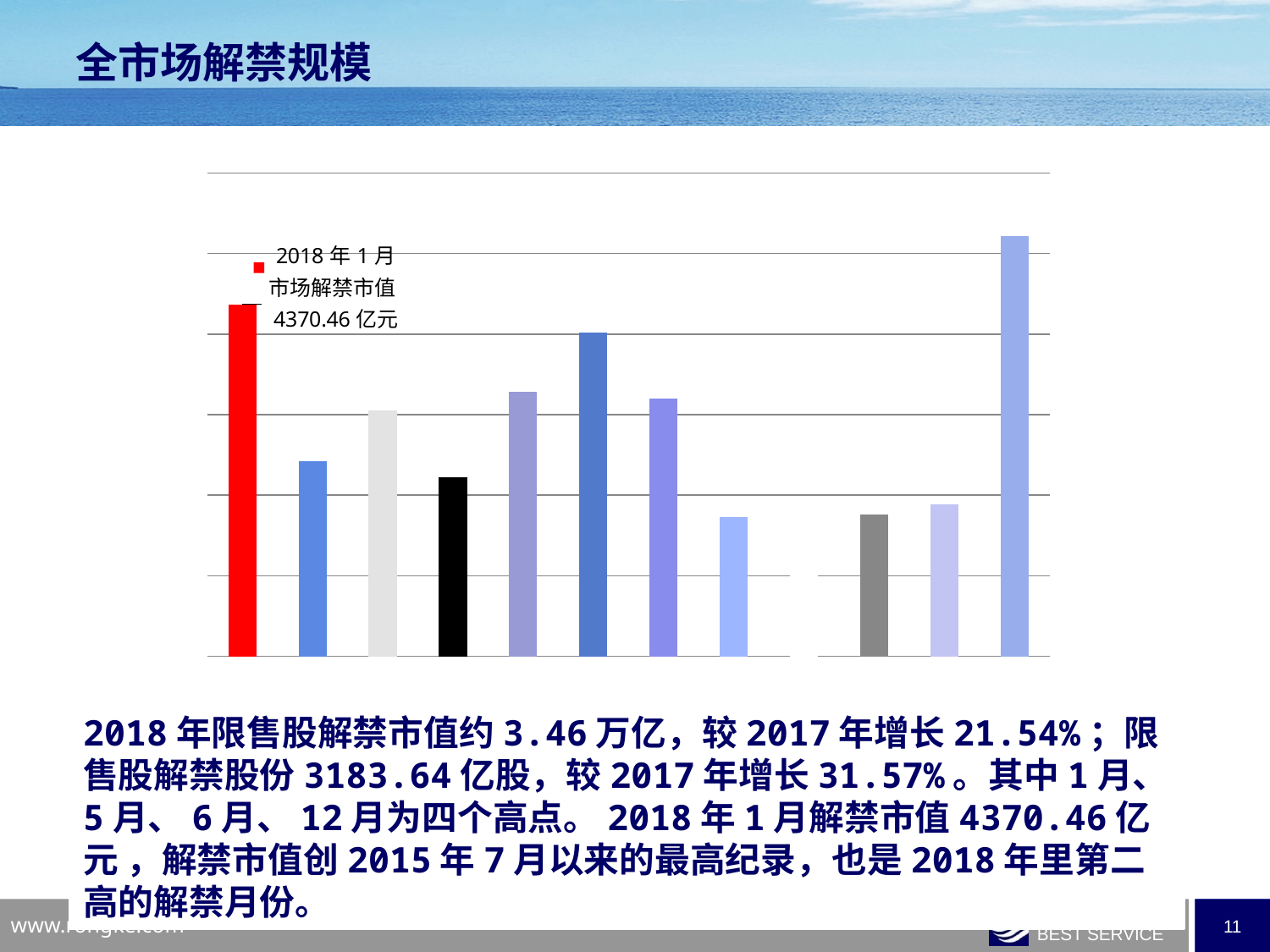
According to the annotation on the chart, what is the market value of unlocked shares (市场解禁市值) for January 2018? 4370.46 亿元 What colour is the bar that the annotation '2018 年 1 月 市场解禁市值 4370.46 亿元' points to? red Is the rightmost bar on the chart taller or shorter than the red bar on the left? taller What kind of chart is shown on the slide? bar chart What is the title of the slide containing the chart? 全市场解禁规模 Which bar on the chart is the tallest: the red bar on the far left or the blue bar on the far right? the blue bar on the far right Is the red bar (January 2018) taller or shorter than the black bar to its right? taller